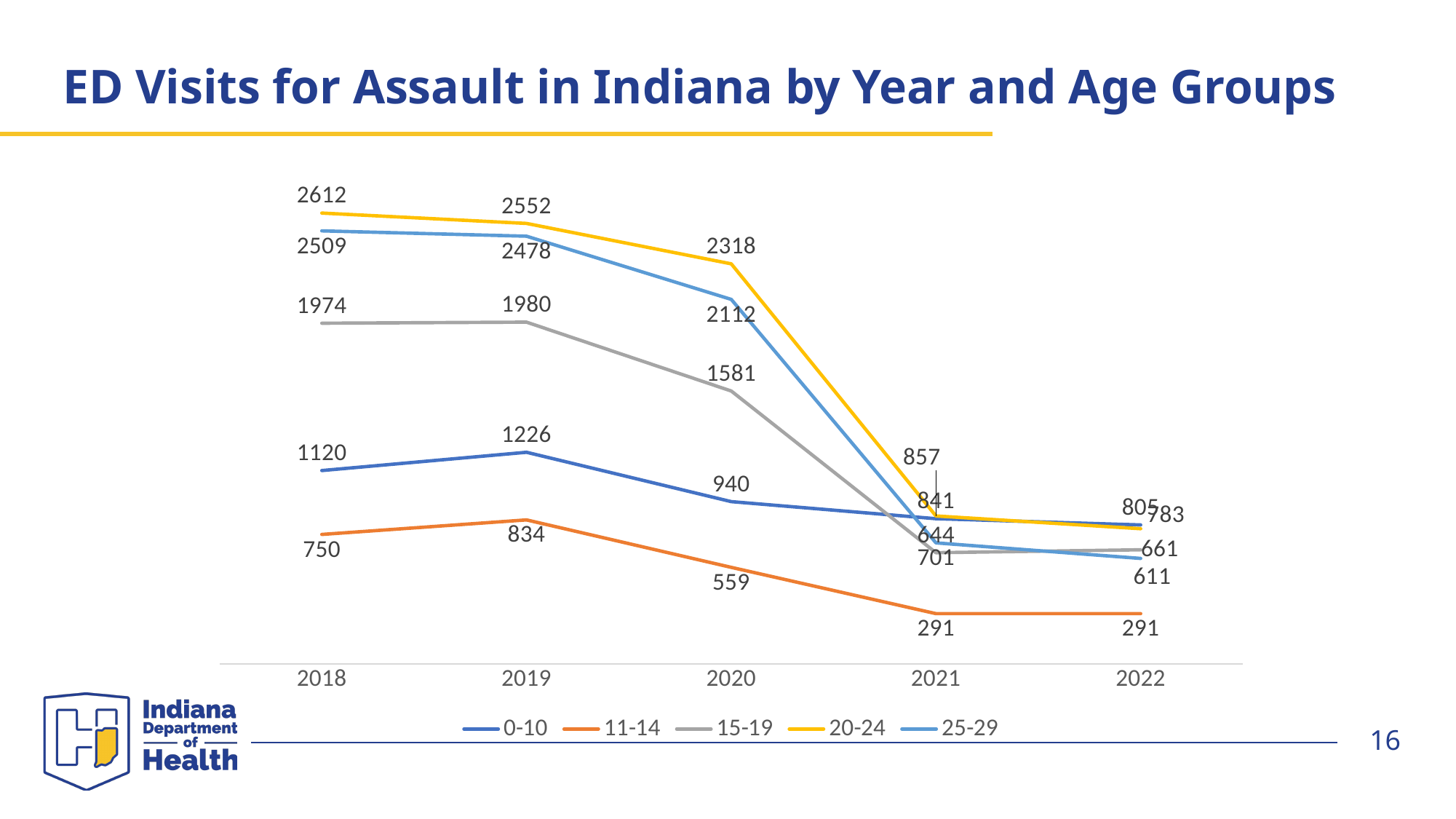
What is the value for the 20-24 age group in 2018? 2612 Which is larger for the 0-10 age group: the 2018 value or the 2019 value? 2019 What is the difference between the 20-24 values in 2018 and 2019? 60 What is the value for the 25-29 age group in 2018? 2509 How many age groups does the legend list? 5 What is the value for the 11-14 age group in 2022? 291 How many years are shown on the x axis? 5 What kind of chart is shown on the slide? Line chart Which age group had the lowest number of ED visits in 2019? 11-14 What is the value for the 11-14 age group in 2020? 559 Which age group had the highest number of ED visits in 2018? 20-24 What is the value for the 15-19 age group in 2020? 1581